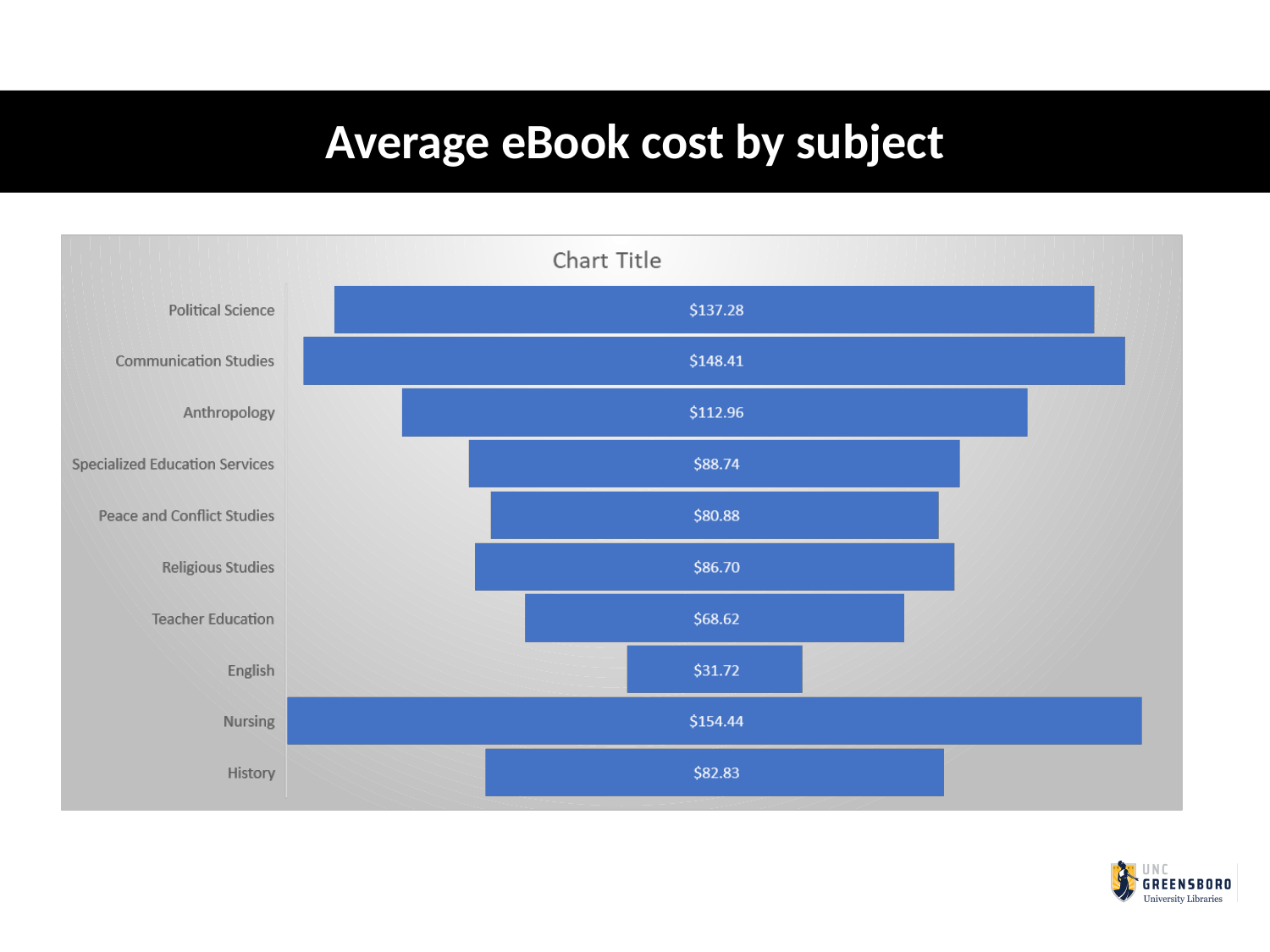
Which has a higher average eBook cost, Specialized Education Services or Peace and Conflict Studies? Specialized Education Services What is the average eBook cost for Religious Studies? $86.70 What is the average eBook cost for English? $31.72 How many subjects are shown in the chart? 10 What is the difference between the average eBook cost for Communication Studies and Political Science? $11.13 What kind of chart is shown on the slide? Bar chart Which subject has the lowest average eBook cost? English What is the average eBook cost for Nursing? $154.44 Which has a higher average eBook cost, History or Teacher Education? History Which subject has the highest average eBook cost? Nursing What is the difference between the average eBook cost for Nursing and English? $122.72 What is the average eBook cost for Anthropology? $112.96